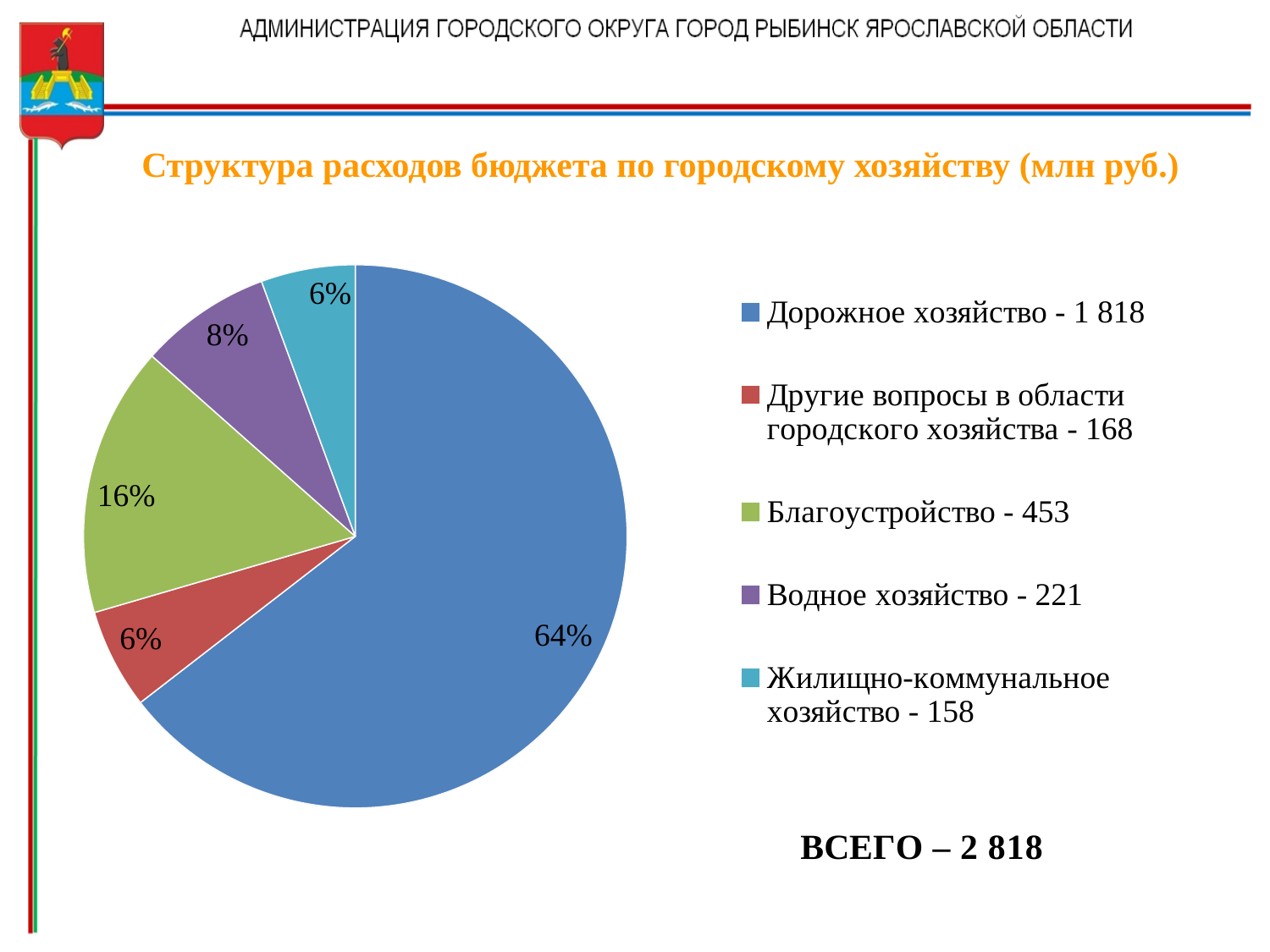
Which category has the smallest value according to the legend? Жилищно-коммунальное хозяйство What value is given in the legend for Жилищно-коммунальное хозяйство? 158 What share of the pie does Водное хозяйство take? 8% What is the difference between the values for Благоустройство and Водное хозяйство? 232 What total (ВСЕГО) is shown on the slide? 2 818 What share of the pie does Дорожное хозяйство take? 64% How many slices does the pie chart have? 5 Which category has the largest slice of the pie? Дорожное хозяйство What kind of chart is shown on the slide? pie chart Which is larger, the value for Другие вопросы в области городского хозяйства or the value for Жилищно-коммунальное хозяйство? Другие вопросы в области городского хозяйства What share of the pie does Благоустройство take? 16% What value is given in the legend for Благоустройство? 453